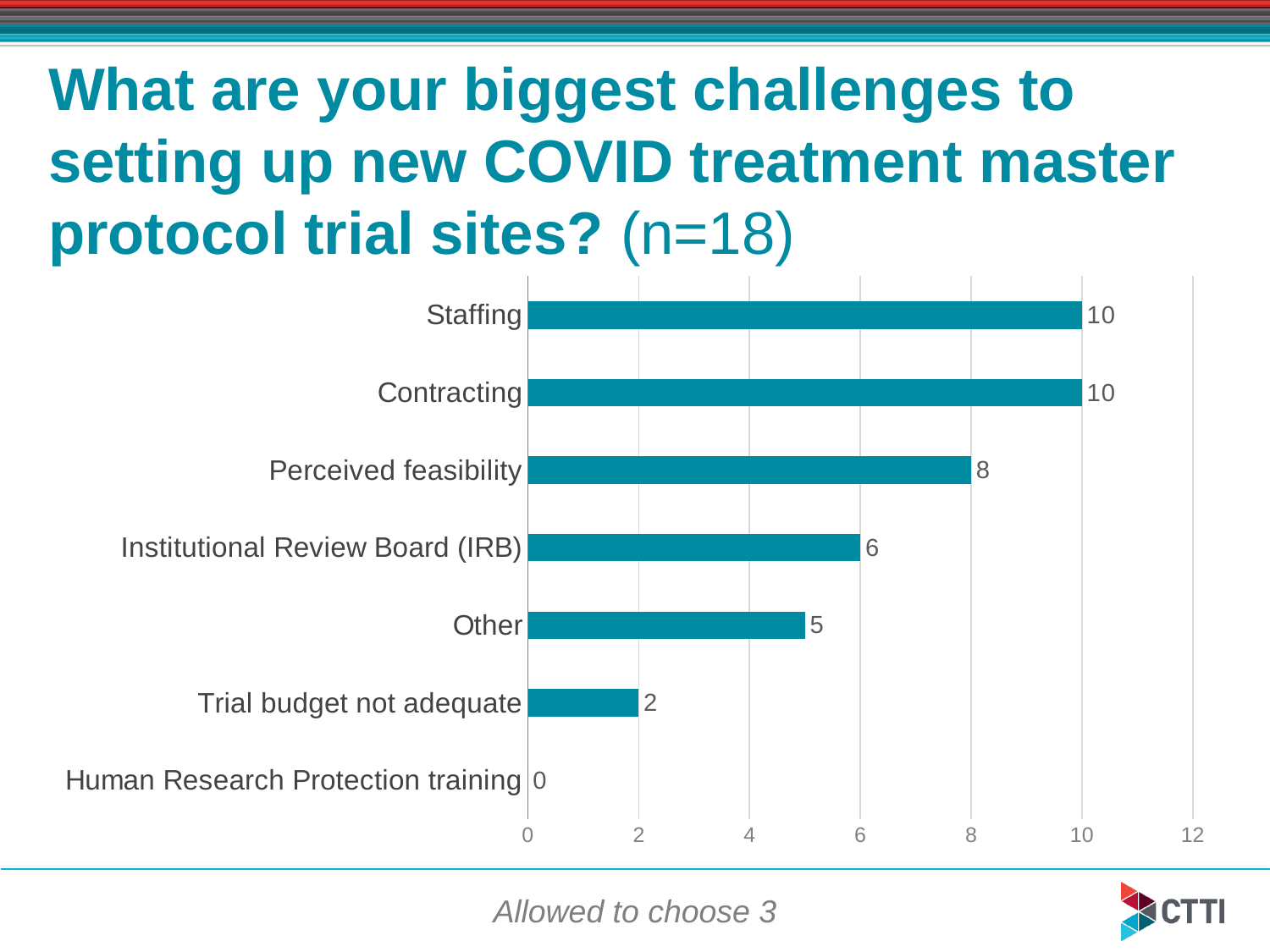
What value is shown for Perceived feasibility? 8 According to the slide, how many respondents (n) answered the question? 18 What is the difference between the values for Perceived feasibility and Other? 3 What value is shown for Staffing? 10 What value is shown for Institutional Review Board (IRB)? 6 Which category has the lowest value? Human Research Protection training Which is larger, the value for Institutional Review Board (IRB) or the value for Other? Institutional Review Board (IRB) What is the highest tick value shown on the horizontal axis? 12 What is the difference between the values for Staffing and Trial budget not adequate? 8 How many categories are shown in the chart? 7 What value is shown for Trial budget not adequate? 2 What kind of chart is shown on the slide? Bar chart